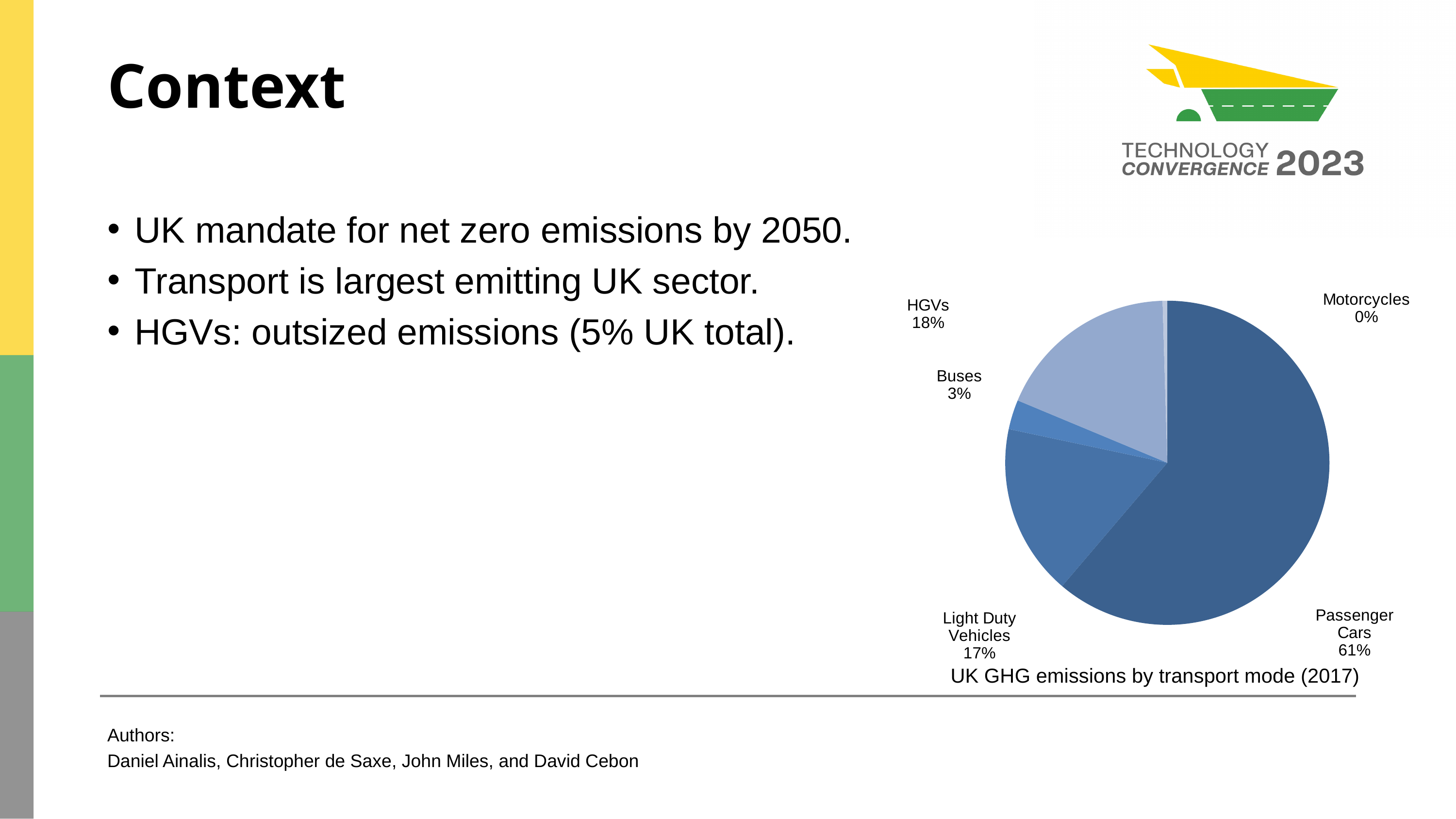
Which transport mode has the largest share of UK GHG emissions in the pie chart? Passenger Cars What is the caption of the pie chart? UK GHG emissions by transport mode (2017) What share of UK GHG emissions by transport mode is attributed to Light Duty Vehicles? 17% What is the difference in percentage points between the Passenger Cars share and the HGVs share? 43 What share of UK GHG emissions by transport mode is attributed to Buses? 3% What share of UK GHG emissions by transport mode is attributed to Passenger Cars? 61% Which has a larger share of UK GHG emissions, HGVs or Buses? HGVs What share of UK GHG emissions by transport mode is attributed to Motorcycles? 0% How many transport modes are shown in the pie chart? 5 Which transport mode has the smallest share of UK GHG emissions in the pie chart? Motorcycles What share of UK GHG emissions by transport mode is attributed to HGVs? 18% What type of chart is shown on the slide? pie chart